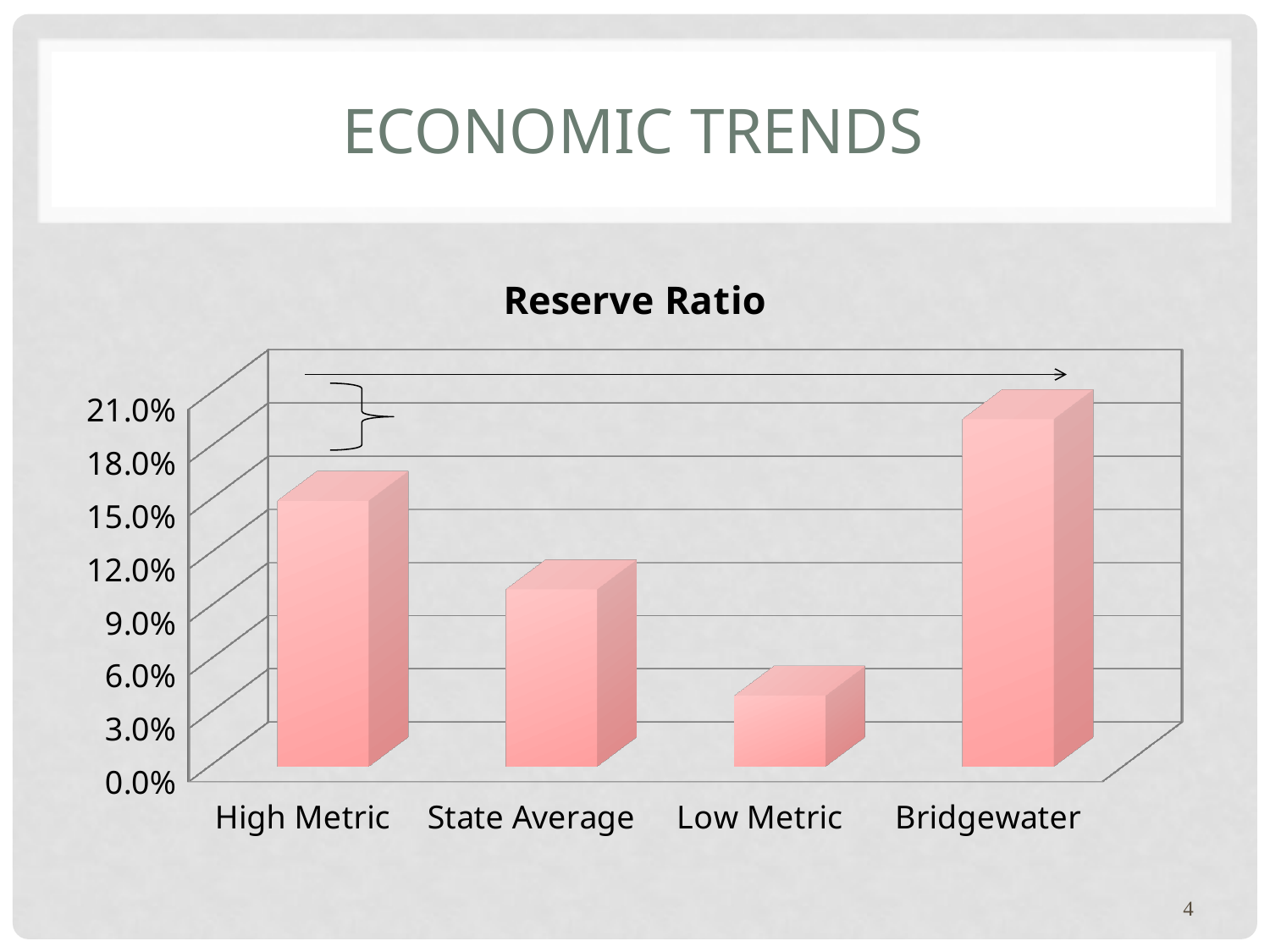
Which category has the lowest reserve ratio? Low Metric Which is larger, the reserve ratio for Bridgewater or for Low Metric? Bridgewater Is the value for State Average greater or less than 15.0%? less Which category has the highest reserve ratio? Bridgewater Is the value for Low Metric greater or less than 6.0%? less Is the value for High Metric greater or less than 12.0%? greater What is the title of the chart? Reserve Ratio How many categories are shown on the x axis of the Reserve Ratio chart? 4 What is the highest value labelled on the vertical axis of the chart? 21.0% Which is larger, the reserve ratio for High Metric or for State Average? High Metric What kind of chart is shown on the slide? bar chart